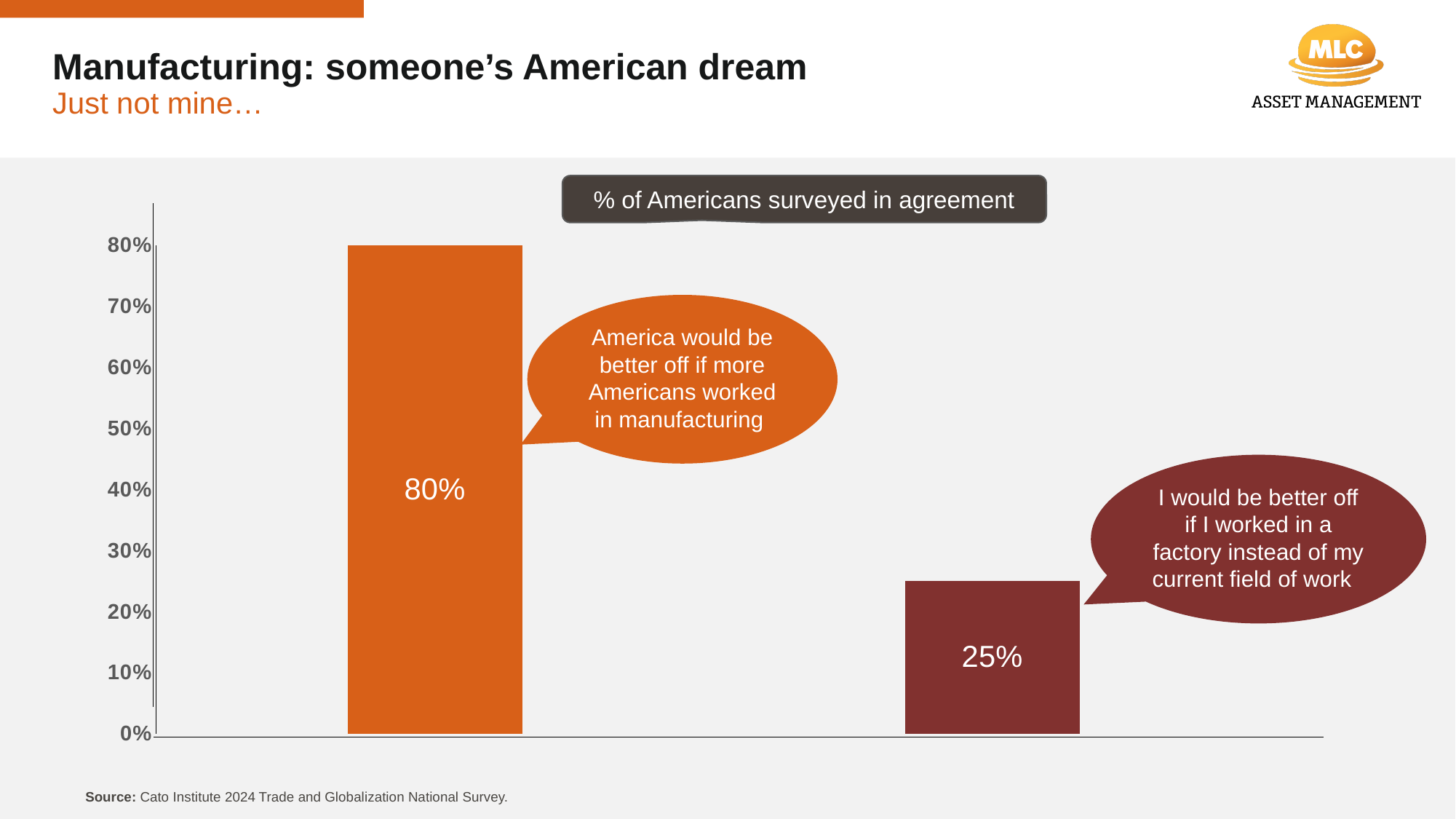
Is the share agreeing that America would be better off with more manufacturing workers larger or smaller than the share agreeing they personally would be better off in a factory? larger What type of chart is shown on the slide? bar chart What percentage of Americans surveyed agree that America would be better off if more Americans worked in manufacturing? 80% Which statement has the lower share of Americans in agreement? I would be better off if I worked in a factory instead of my current field of work Is the value for 'America would be better off if more Americans worked in manufacturing' greater or less than 70%? greater What is the difference in percentage points between the two bars? 55 percentage points What is the source cited for the chart data? Cato Institute 2024 Trade and Globalization National Survey What does the chart's label box say the values represent? % of Americans surveyed in agreement How many bars are plotted on the chart? 2 Is the value for 'I would be better off if I worked in a factory instead of my current field of work' greater or less than 30%? less Which statement has the higher share of Americans in agreement? America would be better off if more Americans worked in manufacturing What percentage of Americans surveyed agree that they would be better off if they worked in a factory instead of their current field of work? 25%